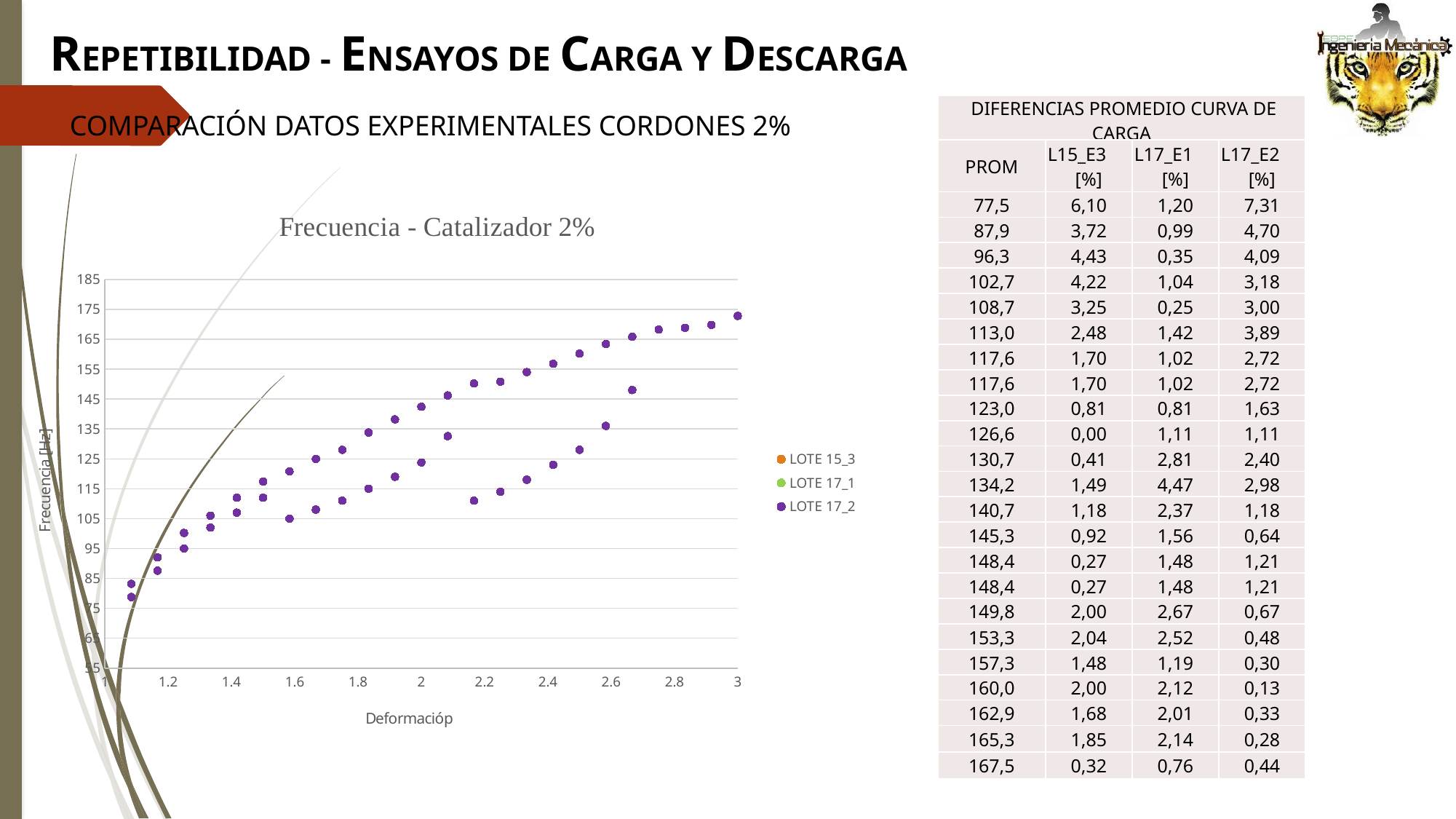
Is the highest plotted frequency value, at a deformation of 3, greater or less than 165? greater How many series does the legend of the chart list? 3 What is the label of the x axis of the chart? Deformación What is the highest value shown on the y axis of the chart? 185 What kind of chart is shown on the slide? scatter chart Is the lowest plotted frequency value, near a deformation of 1.1, greater or less than 95? less Do the plotted frequency values generally rise or fall as deformation increases along the x axis? rise What is the title of the chart? Frecuencia - Catalizador 2% Is the highest plotted frequency value greater or less than 185? less